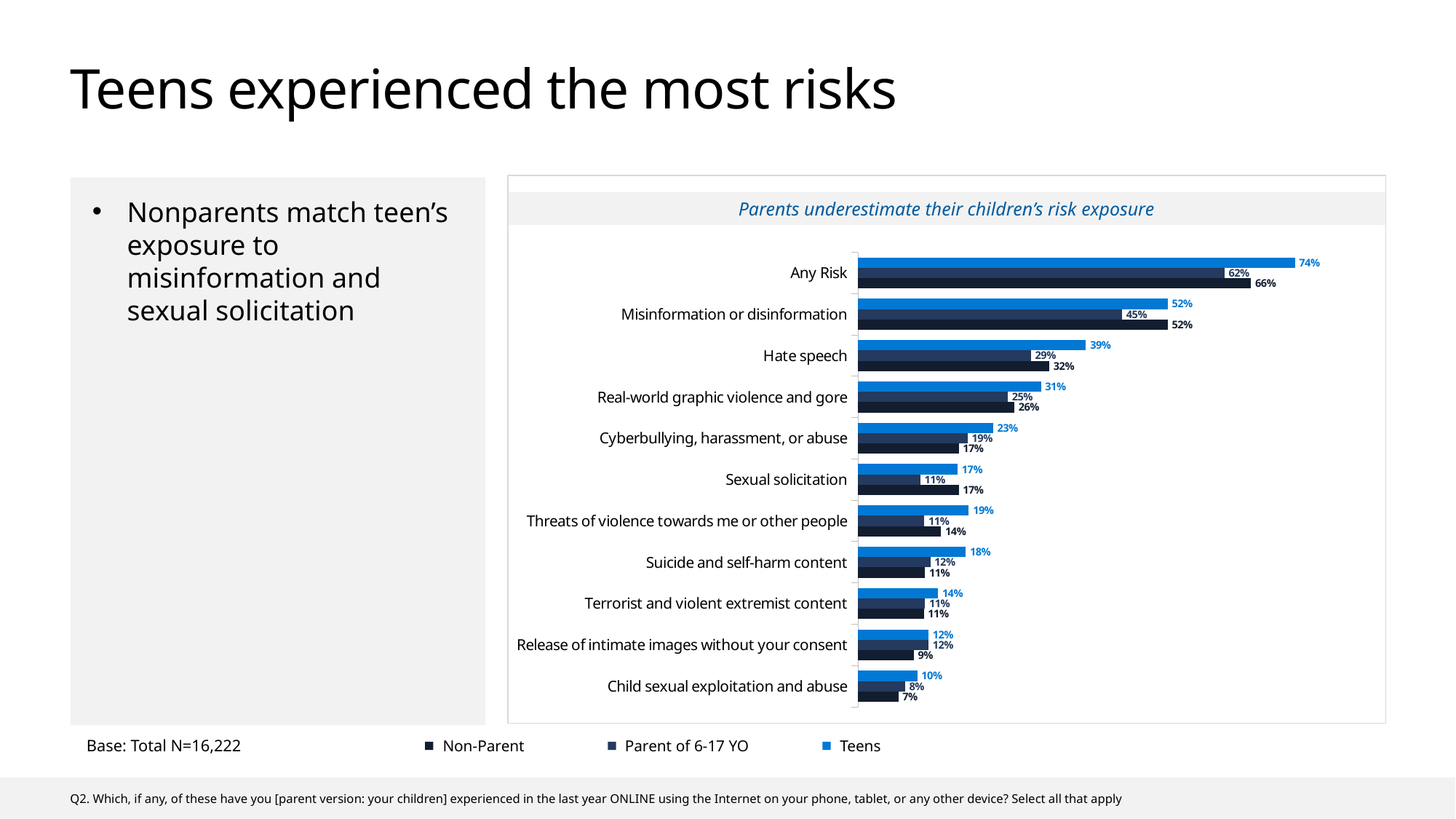
What is the Non-Parent value for Release of intimate images without your consent? 9% Which category has the lowest Teens value? Child sexual exploitation and abuse What percentage of Teens experienced Any Risk? 74% What type of chart is shown on the slide? Bar chart What is the Non-Parent value for Misinformation or disinformation? 52% Which category has the highest Parent of 6-17 YO value? Any Risk For Sexual solicitation, which is larger: the Teens value or the Parent of 6-17 YO value? Teens What is the difference between the Teens and Parent of 6-17 YO values for Any Risk? 12% What is the Parent of 6-17 YO value for Hate speech? 29% How many risk categories are shown on the chart? 11 What is the title of the chart? Parents underestimate their children's risk exposure How many series does the legend list? 3